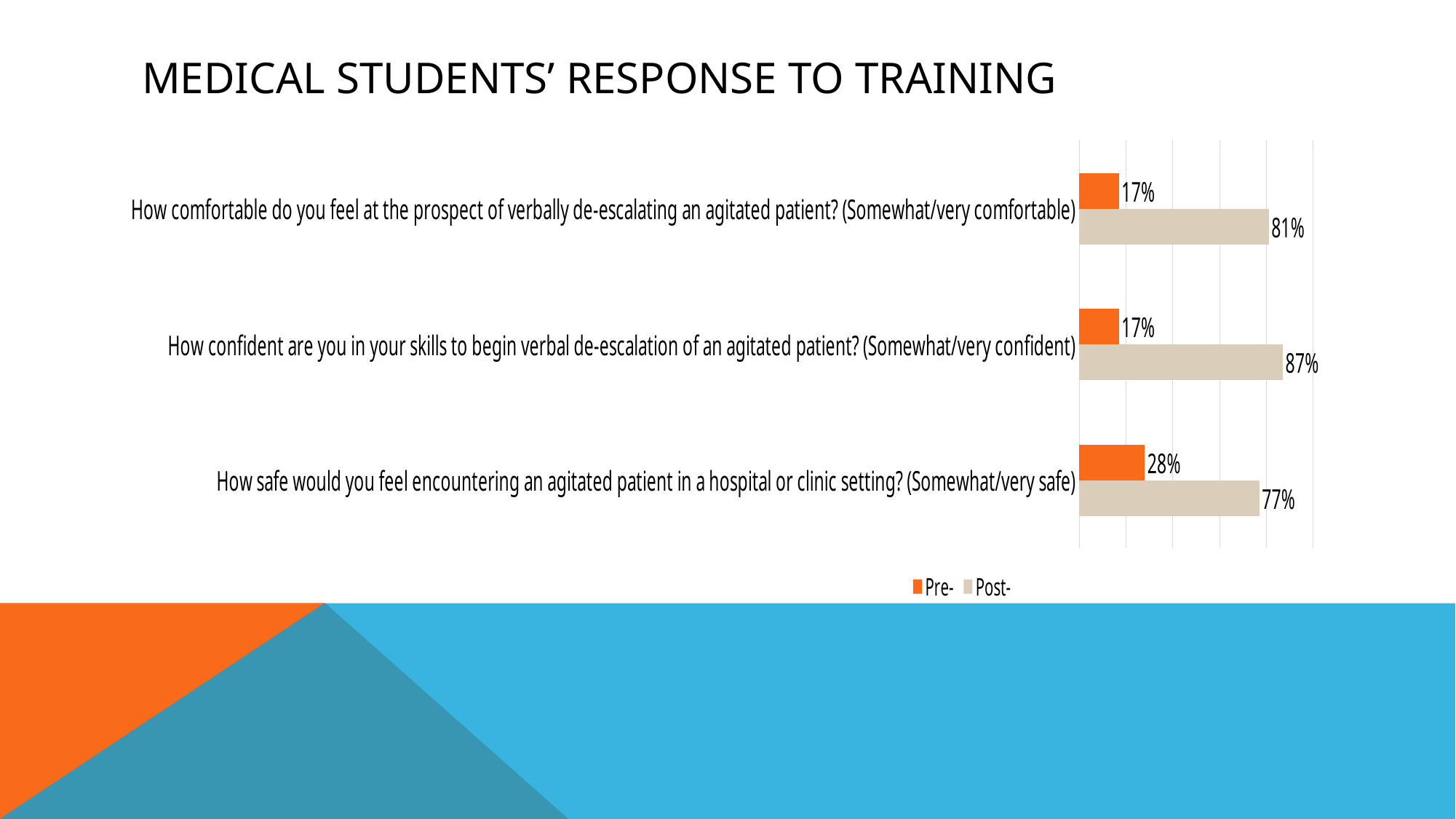
What type of chart is shown on the slide? Bar chart What is the difference between the Post- and Pre- values for "How confident are you in your skills to begin verbal de-escalation of an agitated patient?" 70% Which question has the highest Pre- value? How safe would you feel encountering an agitated patient in a hospital or clinic setting? Which question has the highest Post- value? How confident are you in your skills to begin verbal de-escalation of an agitated patient? Which question has the lowest Post- value? How safe would you feel encountering an agitated patient in a hospital or clinic setting? What is the difference between the Post- and Pre- values for "How safe would you feel encountering an agitated patient in a hospital or clinic setting?" 49% What is the Post- value for "How comfortable do you feel at the prospect of verbally de-escalating an agitated patient?" 81% What is the Pre- value for "How comfortable do you feel at the prospect of verbally de-escalating an agitated patient?" 17% How many series does the legend list? 2 What is the Post- value for "How confident are you in your skills to begin verbal de-escalation of an agitated patient?" 87% What is the Pre- value for "How safe would you feel encountering an agitated patient in a hospital or clinic setting?" 28% Which is larger: the Post- value for the comfort question or the Post- value for the safety question? The Post- value for the comfort question